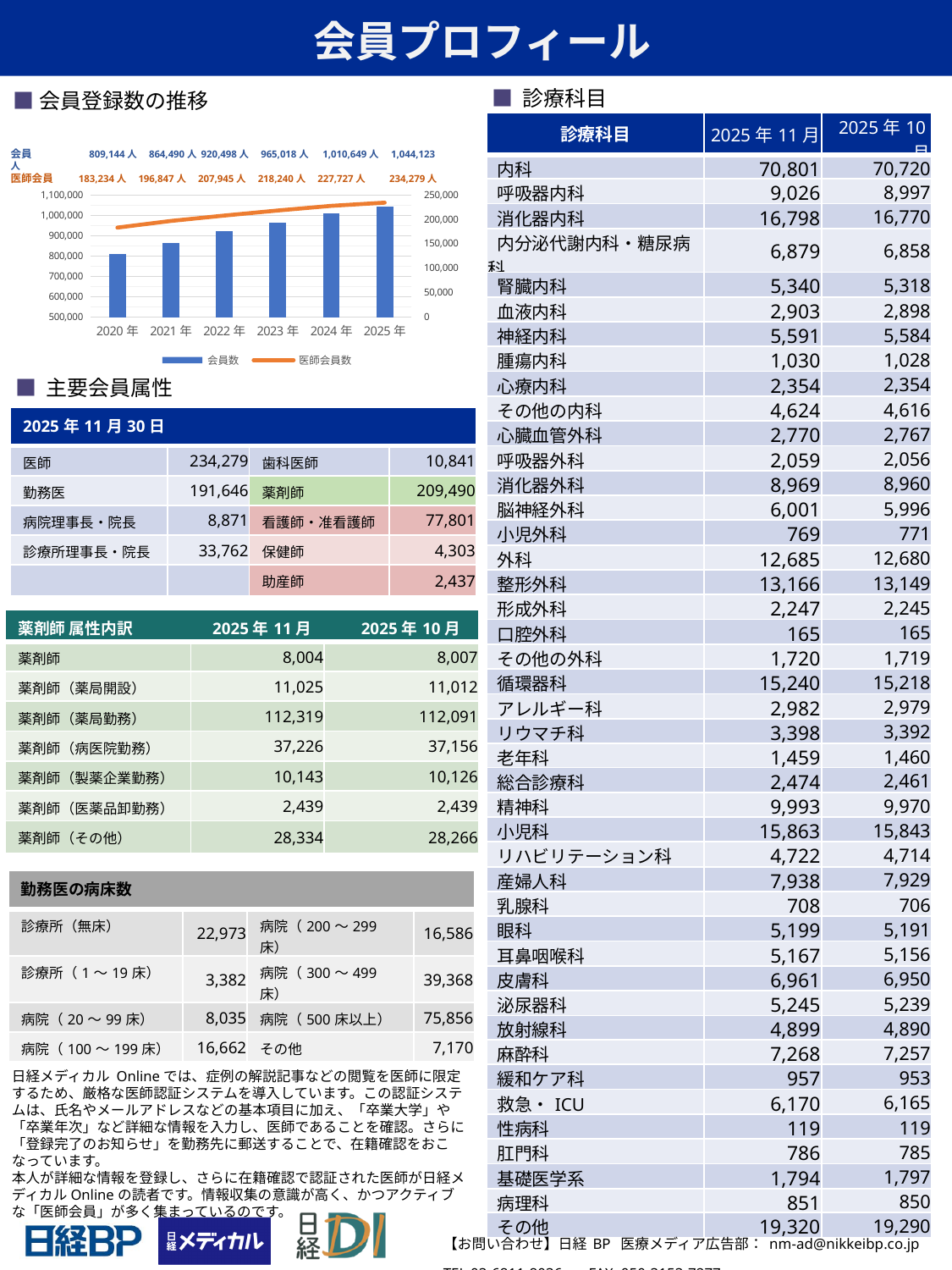
In the 会員登録数の推移 chart, what is the 医師会員 value for 2022年? 207,945人 In the 会員登録数の推移 chart, what is the 会員 value for 2023年? 965,018人 How many series does the legend of the 会員登録数の推移 chart list? 2 In the 会員登録数の推移 chart, what is the 医師会員 value for 2025年? 234,279人 In the 会員登録数の推移 chart, what is the 会員 value for 2020年? 809,144人 How many years are shown on the x axis of the 会員登録数の推移 chart? 6 In the 会員登録数の推移 chart, what is the difference between the 医師会員 values for 2025年 and 2020年? 51,045 In the 会員登録数の推移 chart, which is larger, the 会員 value for 2021年 or for 2022年? 2022年 In the 会員登録数の推移 chart, what is the difference between the 会員 values for 2025年 and 2020年? 234,979 In the 会員登録数の推移 chart, which year has the lowest 医師会員 value? 2020年 Do the 会員数 bars in the 会員登録数の推移 chart rise or fall from 2020年 to 2025年? rise In the 会員登録数の推移 chart, which year has the highest 会員 value? 2025年